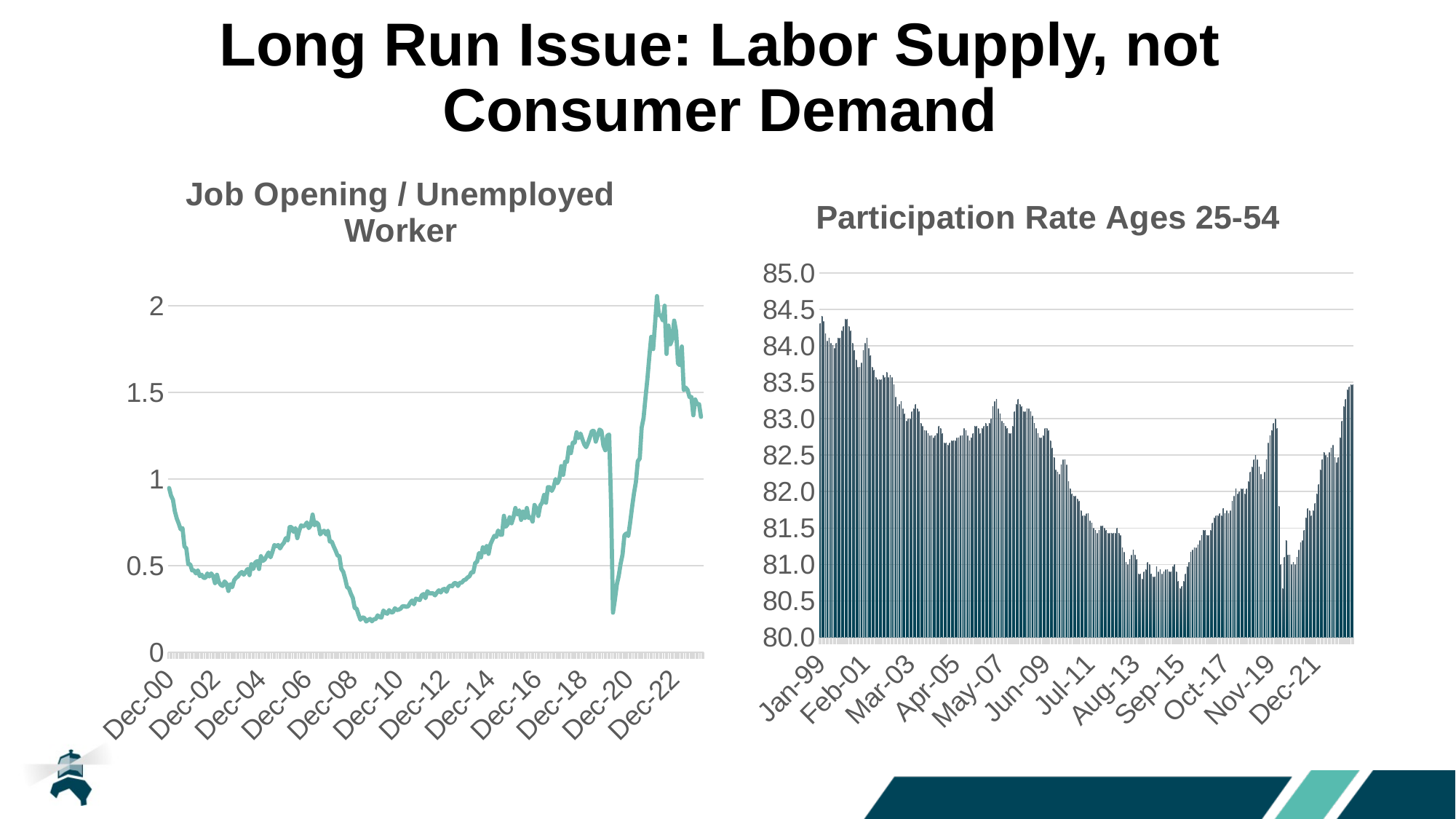
In the 'Job Opening / Unemployed Worker' chart, does the line rise or fall between Dec-10 and Dec-18? rise In the 'Participation Rate Ages 25-54' chart, is the value at Mar-03 greater or less than 82.5? greater In the 'Job Opening / Unemployed Worker' chart, is the value at Dec-20 greater or less than 0.5? greater In the 'Job Opening / Unemployed Worker' chart, is the value at Dec-10 greater or less than 0.5? less In the 'Participation Rate Ages 25-54' chart, do the values rise or fall between Sep-15 and Dec-21? rise What kind of chart is the 'Participation Rate Ages 25-54' chart? bar chart What is the title of the chart on the right side of the slide? Participation Rate Ages 25-54 What kind of chart is the 'Job Opening / Unemployed Worker' chart? line chart In the 'Participation Rate Ages 25-54' chart, which is larger, the value at Jan-99 or the value at Sep-15? Jan-99